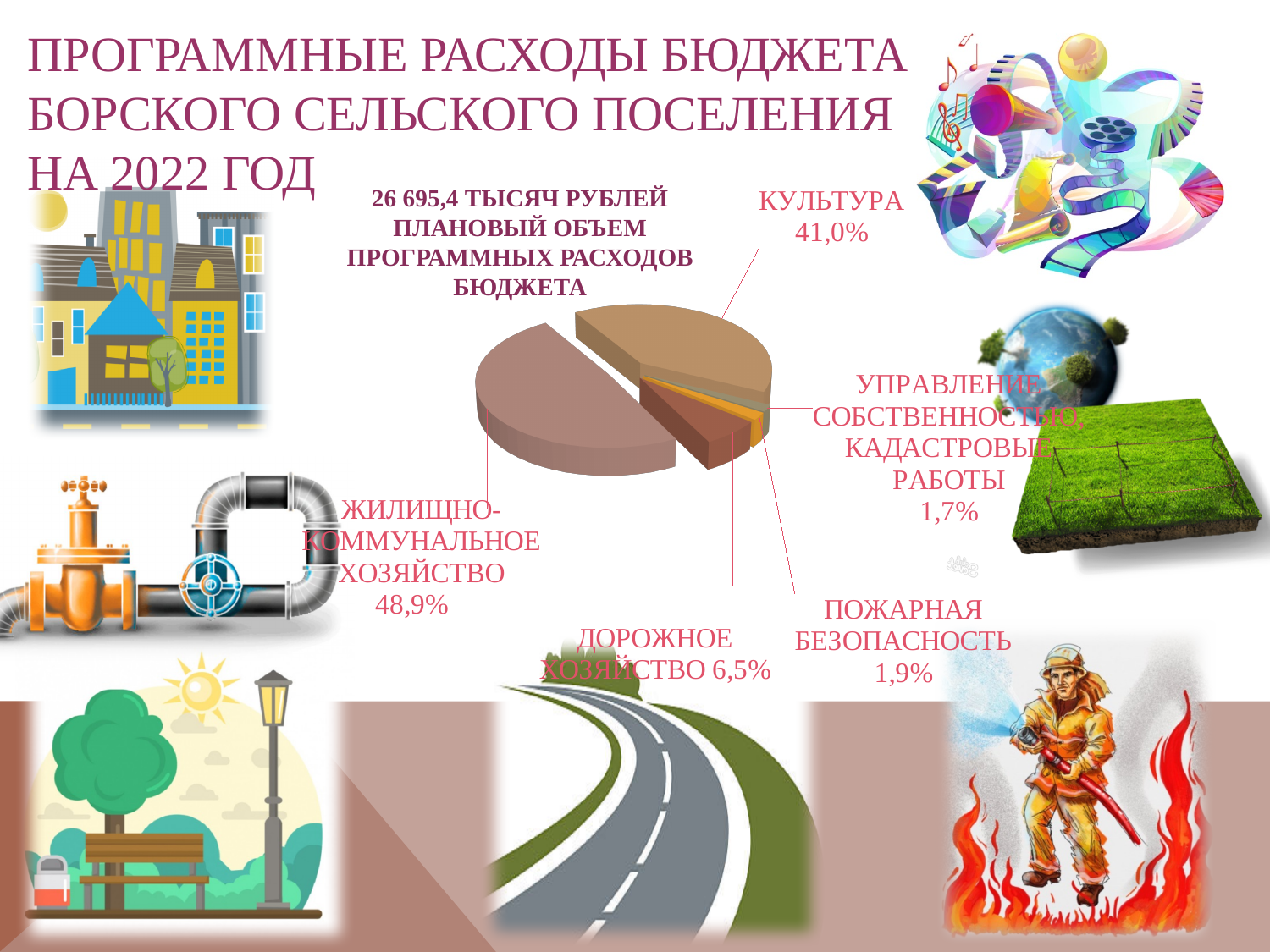
What share is shown for УПРАВЛЕНИЕ СОБСТВЕННОСТЬЮ, КАДАСТРОВЫЕ РАБОТЫ? 1,7% What share of the programme budget expenditure goes to ЖИЛИЩНО-КОММУНАЛЬНОЕ ХОЗЯЙСТВО? 48,9% What share of the programme budget expenditure goes to КУЛЬТУРА? 41,0% Which category has the largest share of the pie? ЖИЛИЩНО-КОММУНАЛЬНОЕ ХОЗЯЙСТВО By how many percentage points does ЖИЛИЩНО-КОММУНАЛЬНОЕ ХОЗЯЙСТВО exceed КУЛЬТУРА? 7,9 What is the planned total volume of programme budget expenditure stated on the slide? 26 695,4 тысяч рублей How many categories are shown in the pie chart? 5 Which is larger, the share for ДОРОЖНОЕ ХОЗЯЙСТВО or the share for ПОЖАРНАЯ БЕЗОПАСНОСТЬ? ДОРОЖНОЕ ХОЗЯЙСТВО What share is shown for ДОРОЖНОЕ ХОЗЯЙСТВО? 6,5% Which category has the smallest share of the pie? УПРАВЛЕНИЕ СОБСТВЕННОСТЬЮ, КАДАСТРОВЫЕ РАБОТЫ What kind of chart is shown on the slide? Pie chart What share is shown for ПОЖАРНАЯ БЕЗОПАСНОСТЬ? 1,9%